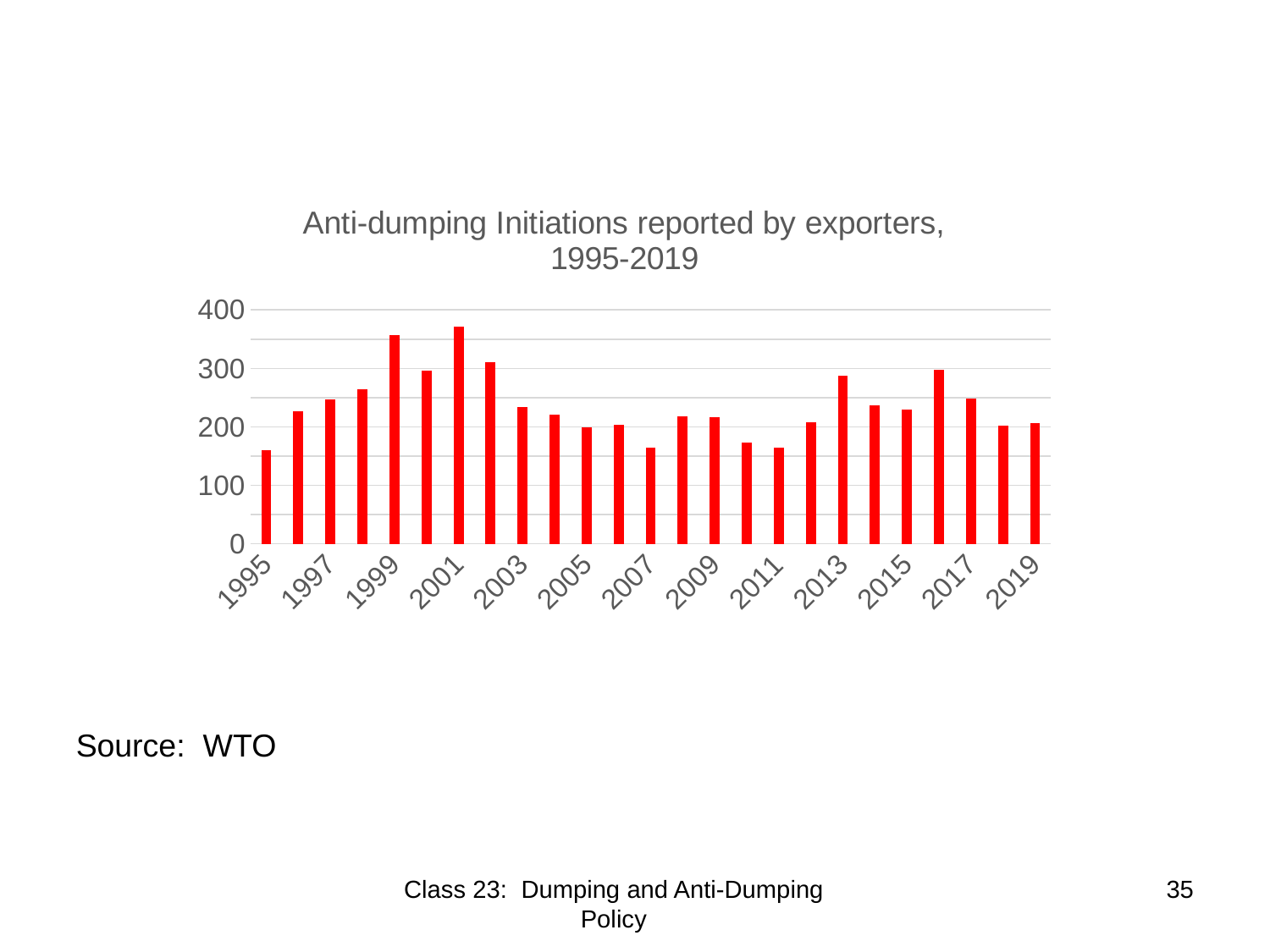
Which year has the larger value, 2013 or 2015? 2013 Is the value for 1995 greater or less than 200? less Is the value for 1999 greater or less than 300? greater Do the values generally rise or fall from 1995 to 2001? rise What kind of chart is shown on the slide? bar chart Is the value for 2011 greater or less than 200? less Which year has the larger value, 2001 or 2011? 2001 Which year has the highest number of anti-dumping initiations? 2001 What is the title of the chart? Anti-dumping Initiations reported by exporters, 1995-2019 How many bars (years) are plotted in the chart? 25